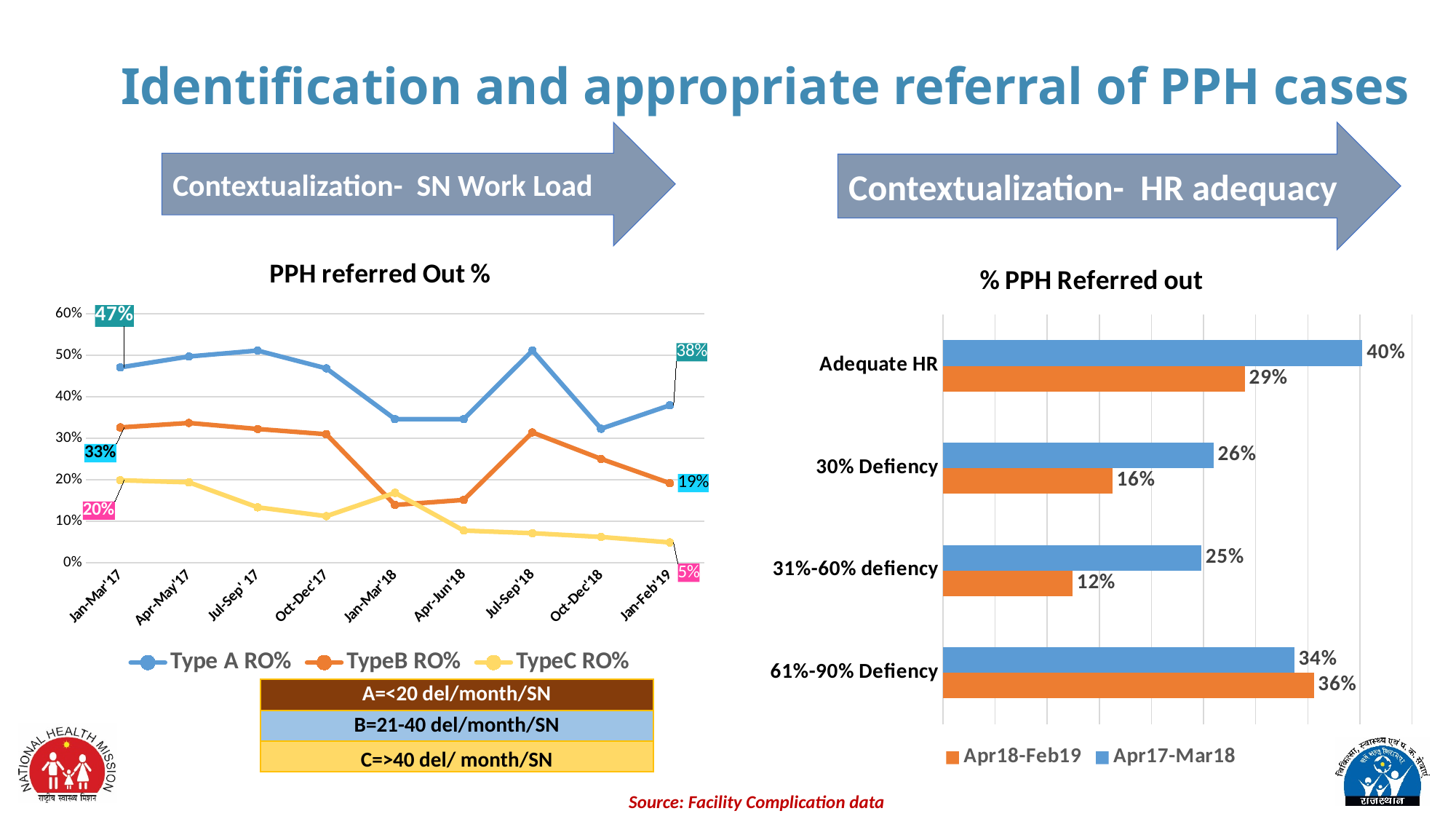
In the '% PPH Referred out' bar chart, what is the difference between the Apr17-Mar18 and Apr18-Feb19 values for 30% Defiency? 10% How many series does the legend of the '% PPH Referred out' bar chart list? 2 In the 'PPH referred Out %' line chart, what is the TypeC RO% value for Jan-Feb'19? 5% In the '% PPH Referred out' bar chart, which category has the lowest Apr18-Feb19 value? 31%-60% defiency What kind of chart is the '% PPH Referred out' chart? Bar chart In the 'PPH referred Out %' line chart, how many time periods are shown on the x axis? 9 In the '% PPH Referred out' bar chart, what is the value for 31%-60% defiency in Apr18-Feb19? 12% In the '% PPH Referred out' bar chart, what is the value for Adequate HR in Apr17-Mar18? 40% In the '% PPH Referred out' bar chart, for 61%-90% Defiency, which period has the larger value, Apr18-Feb19 or Apr17-Mar18? Apr18-Feb19 In the 'PPH referred Out %' line chart, what is the Type A RO% value for Jan-Mar'17? 47% In the '% PPH Referred out' bar chart, which category has the highest Apr17-Mar18 value? Adequate HR In the 'PPH referred Out %' line chart, does the TypeC RO% series rise or fall from Jan-Mar'17 to Jan-Feb'19? Fall